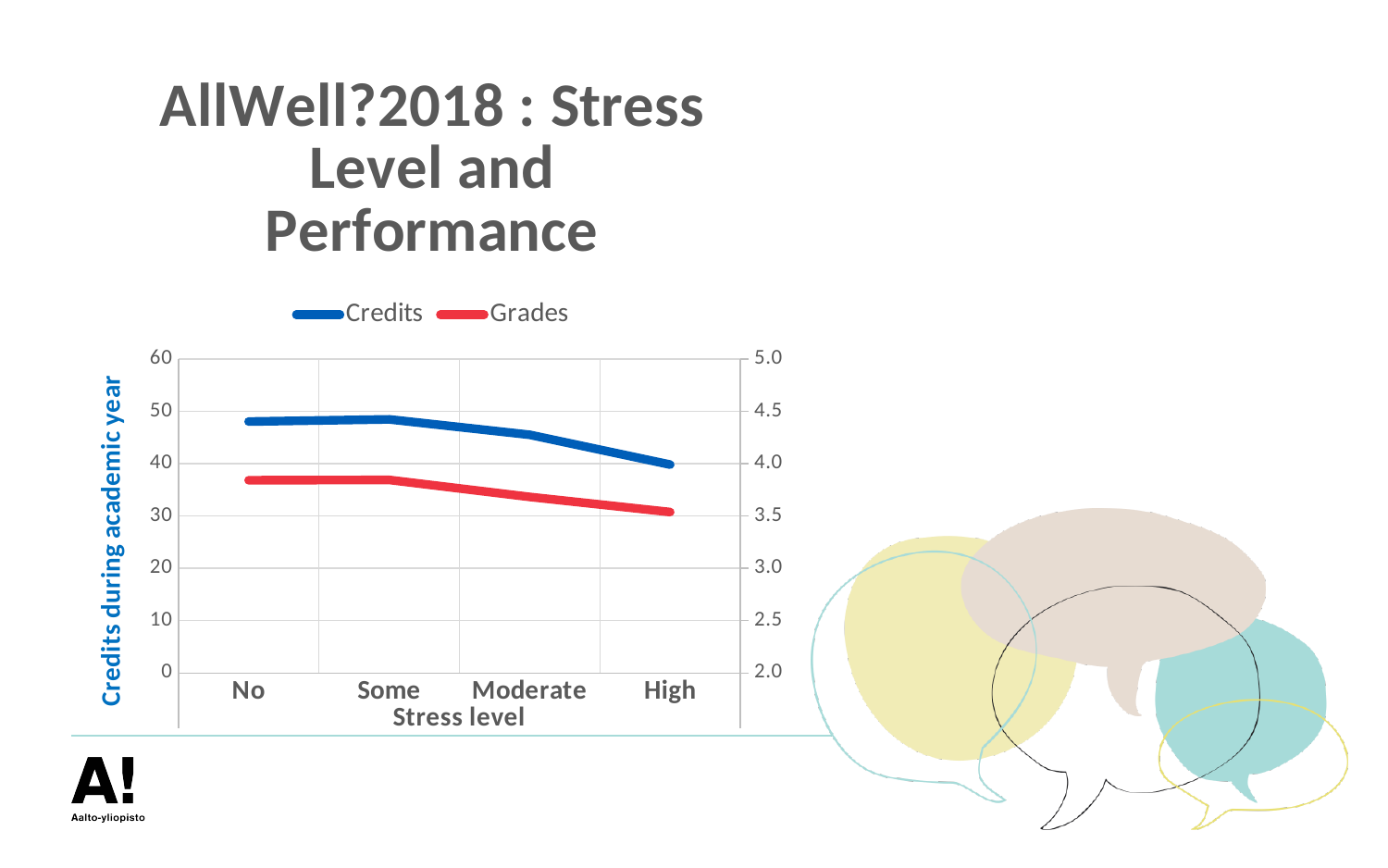
Is the Grades value for High stress greater or less than 4.0? less Is the Credits value for Moderate stress greater or less than 50? less Which stress level has the lowest value for Grades? High Do the Credits values rise or fall as stress level increases from No to High? fall Is the Grades value for No stress greater or less than 3.5? greater How many series does the legend list? 2 Which is larger, the Credits value for No stress or for High stress? No Which stress level has the lowest value for Credits? High What is the label of the left vertical axis? Credits during academic year How many stress level categories are shown on the x axis? 4 What kind of chart is shown on the slide? line chart